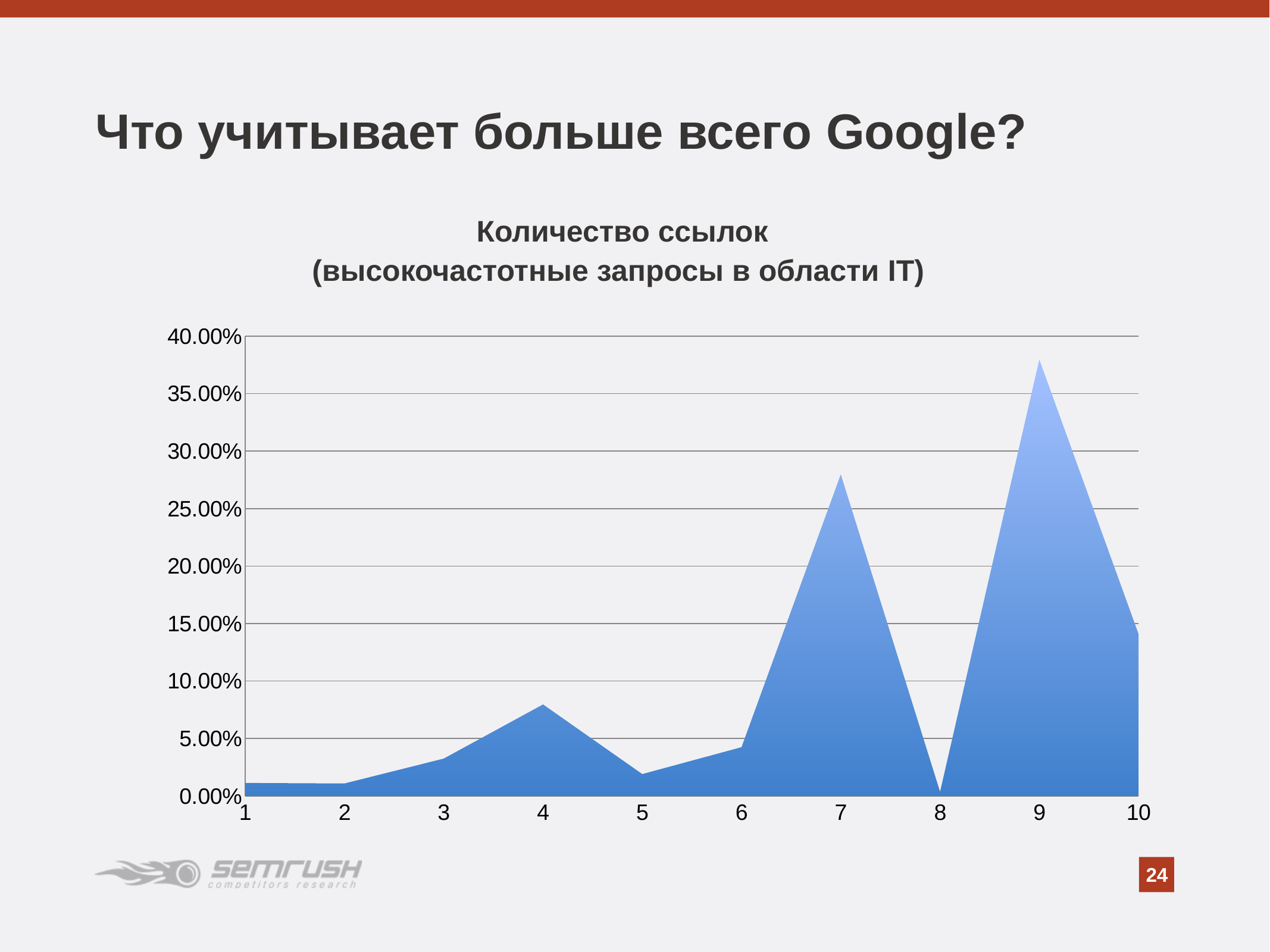
Is the value at x = 4 greater or less than 10.00%? less Which is larger, the value at x = 7 or the value at x = 10? 7 Which x-axis category has the highest value? 9 Is the value at x = 9 greater or less than 35.00%? greater How many points are plotted along the x axis? 10 Which x-axis category has the lowest value? 8 Does the value rise or fall from x = 7 to x = 8? fall What kind of chart is shown on the slide? area chart Is the value at x = 7 greater or less than 25.00%? greater What is the title of the chart? Количество ссылок (высокочастотные запросы в области IT)